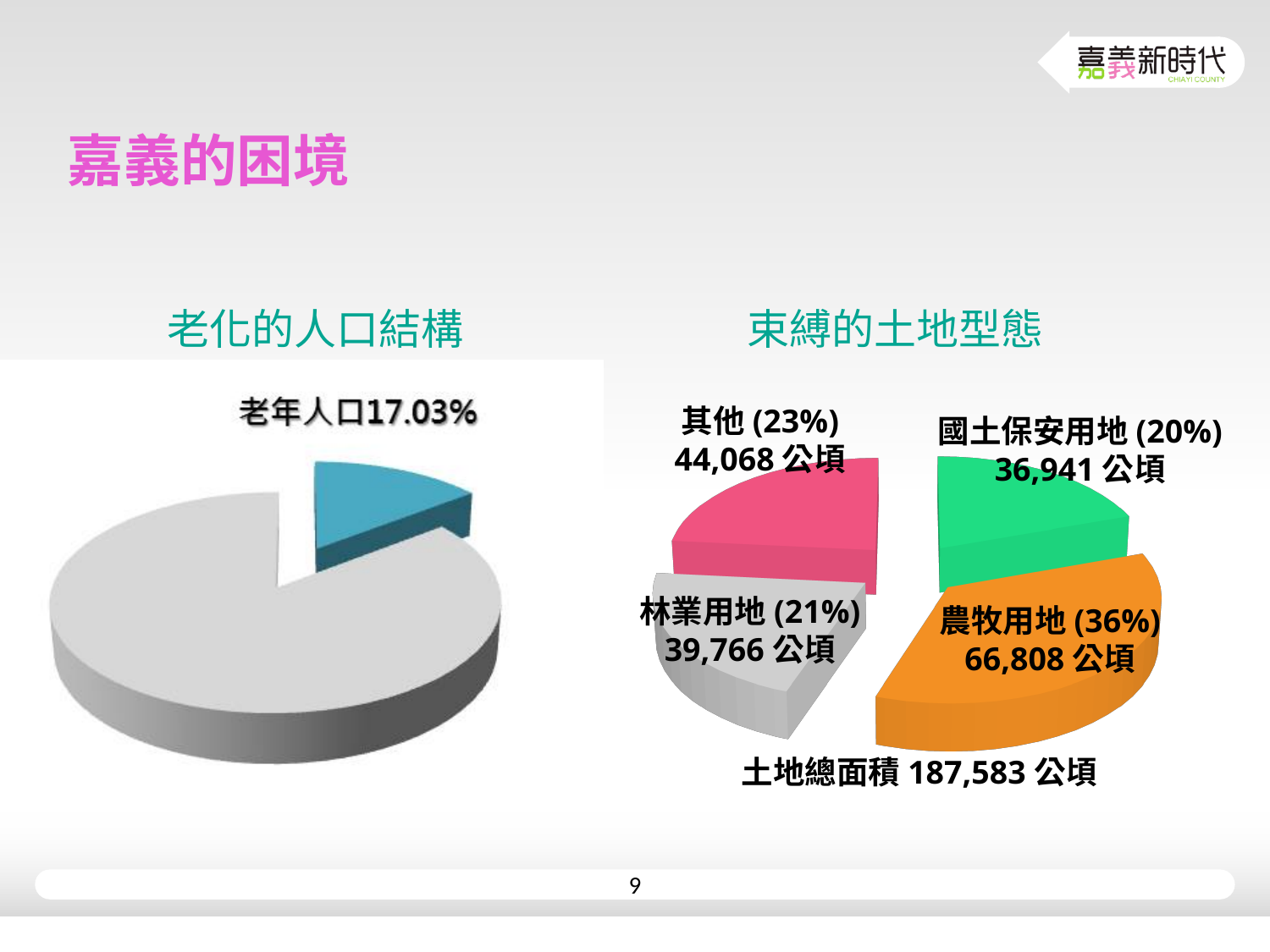
In the right-hand chart (束縛的土地型態), which land type has the smallest area? 國土保安用地 In the right-hand chart (束縛的土地型態), what is the area of 國土保安用地? 36,941 公頃 In the right-hand chart (束縛的土地型態), what is the total land area shown? 187,583 公頃 In the right-hand chart (束縛的土地型態), which land type has the largest area? 農牧用地 In the right-hand chart (束縛的土地型態), what is the difference in area between 農牧用地 and 其他? 22,740 公頃 In the right-hand chart (束縛的土地型態), what percentage share does 林業用地 have? 21% In the right-hand chart (束縛的土地型態), what is the area of 農牧用地? 66,808 公頃 In the right-hand chart (束縛的土地型態), how many land-type slices are shown? 4 In the right-hand chart (束縛的土地型態), which is larger in area, 林業用地 or 國土保安用地? 林業用地 In the left-hand chart (老化的人口結構), what percentage of the population is 老年人口? 17.03% What kind of chart is used in the left-hand chart (老化的人口結構)? Pie chart In the right-hand chart (束縛的土地型態), what percentage share does 其他 have? 23%